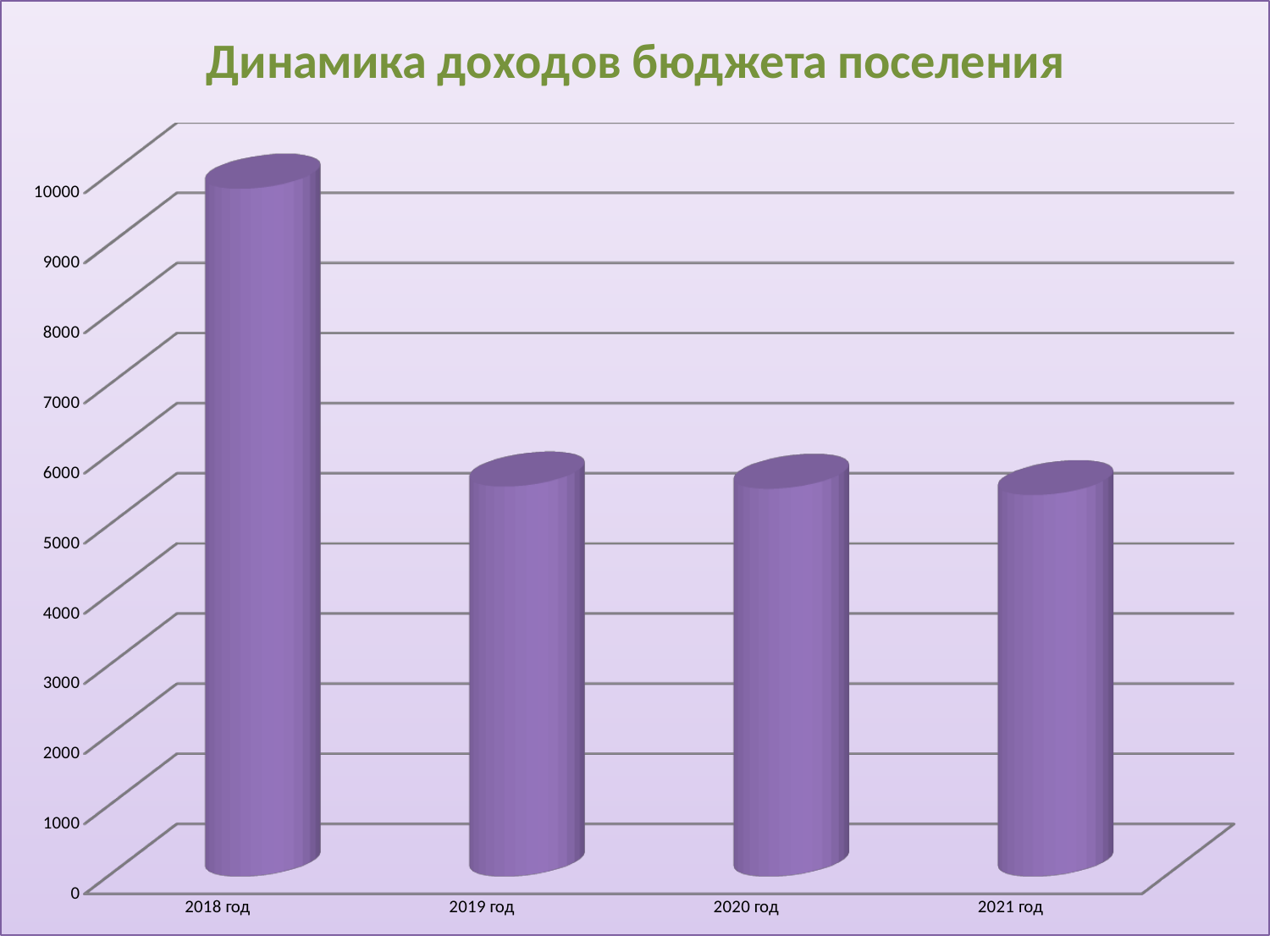
Do the values rise or fall from 2018 год to 2019 год? fall What colour are the bars in the chart? Purple Is the value for 2021 год greater or less than 8000? less Is the value for 2020 год greater or less than 7000? less What is the title of the chart? Динамика доходов бюджета поселения Which year has the highest value? 2018 год Is the value for 2018 год greater or less than 9000? greater What kind of chart is shown on the slide? Bar chart How many categories (years) are shown on the x axis? 4 Which is larger, the value for 2018 год or the value for 2021 год? 2018 год Which is larger, the value for 2018 год or the value for 2019 год? 2018 год